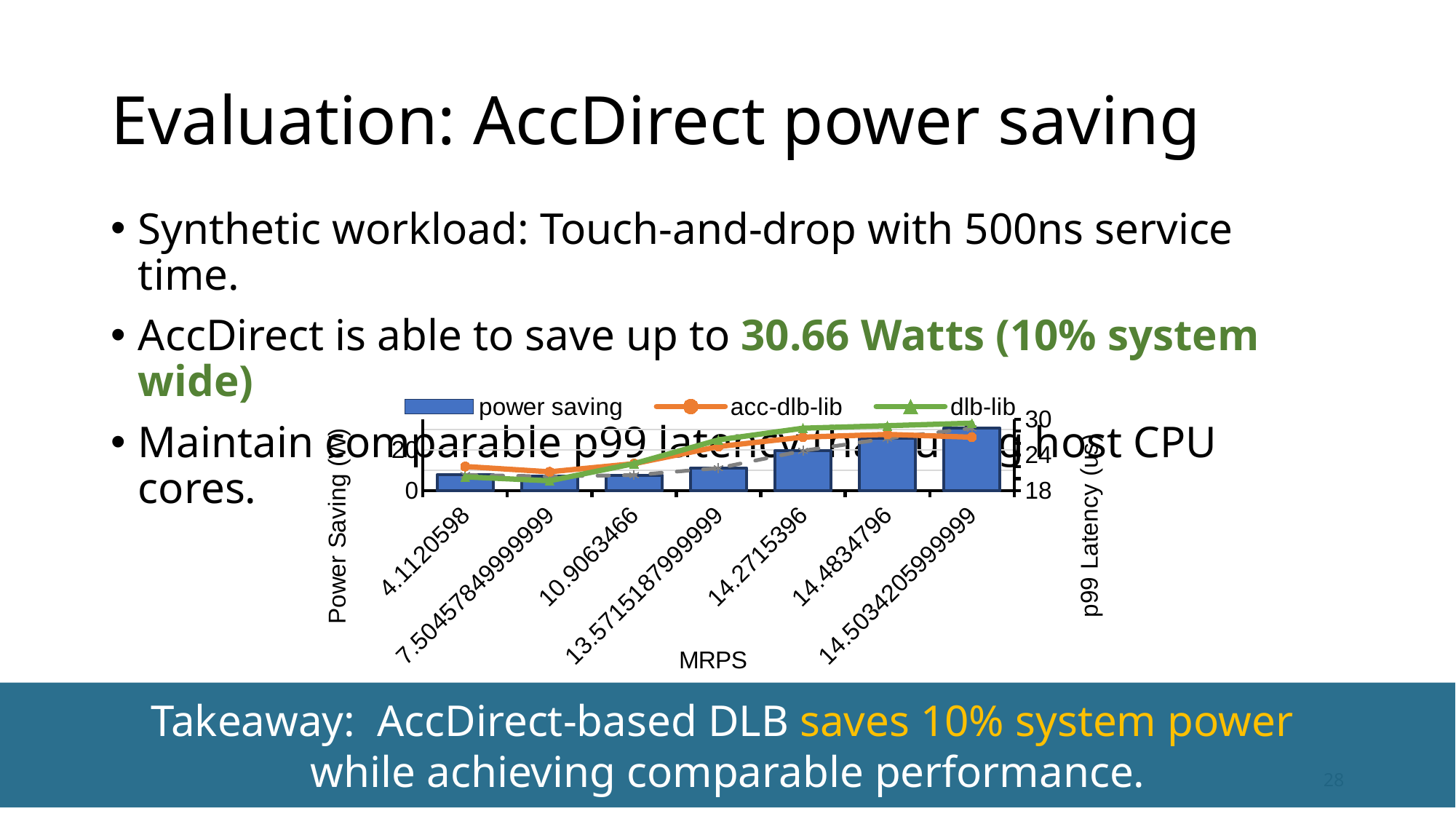
What kind of chart is shown on the slide? A combined bar and line chart Which MRPS category has the highest power saving bar? 14.5034205999999 What is the label of the right-hand y axis of the chart? p99 Latency (us) Is the power saving value at 14.5034205999999 MRPS greater or less than 20 W? greater Do the power saving bars rise or fall as MRPS increases along the x axis? Rise Which is larger at 14.5034205999999 MRPS: the dlb-lib p99 latency or the acc-dlb-lib p99 latency? dlb-lib How many series does the chart legend list? 3 Is the dlb-lib p99 latency at 4.1120598 MRPS greater or less than 24 us? less What is the label of the x axis of the chart? MRPS How many MRPS categories are shown on the x axis of the chart? 7 Is the power saving value at 4.1120598 MRPS greater or less than 20 W? less